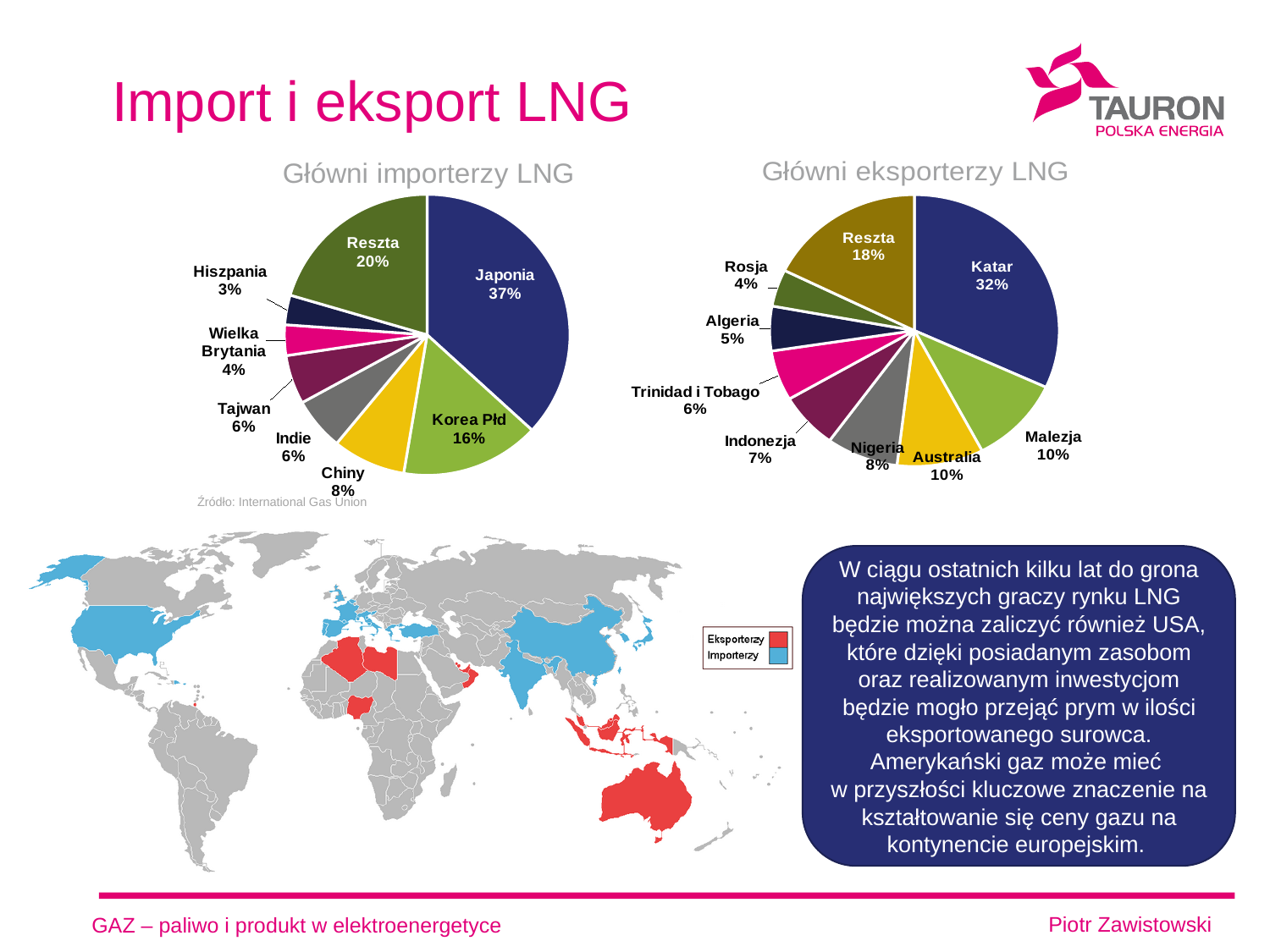
In the 'Główni eksporterzy LNG' chart, which named country has the largest share? Katar In the 'Główni eksporterzy LNG' chart, what share does Katar have? 32% What type of chart is 'Główni eksporterzy LNG'? Pie chart In the 'Główni importerzy LNG' chart, what share does Japonia have? 37% How many slices does the 'Główni importerzy LNG' pie chart have? 8 In the 'Główni eksporterzy LNG' chart, what is the difference between the shares of Katar and Malezja? 22% How many slices does the 'Główni eksporterzy LNG' pie chart have? 9 In the 'Główni importerzy LNG' chart, which named country has the smallest share? Hiszpania In the 'Główni eksporterzy LNG' chart, which has a larger share, Nigeria or Rosja? Nigeria In the 'Główni importerzy LNG' chart, what is the difference between the shares of Japonia and Korea Płd? 21% In the 'Główni eksporterzy LNG' chart, what is the share for Trinidad i Tobago? 6% In the 'Główni importerzy LNG' chart, what is the share for Korea Płd? 16%